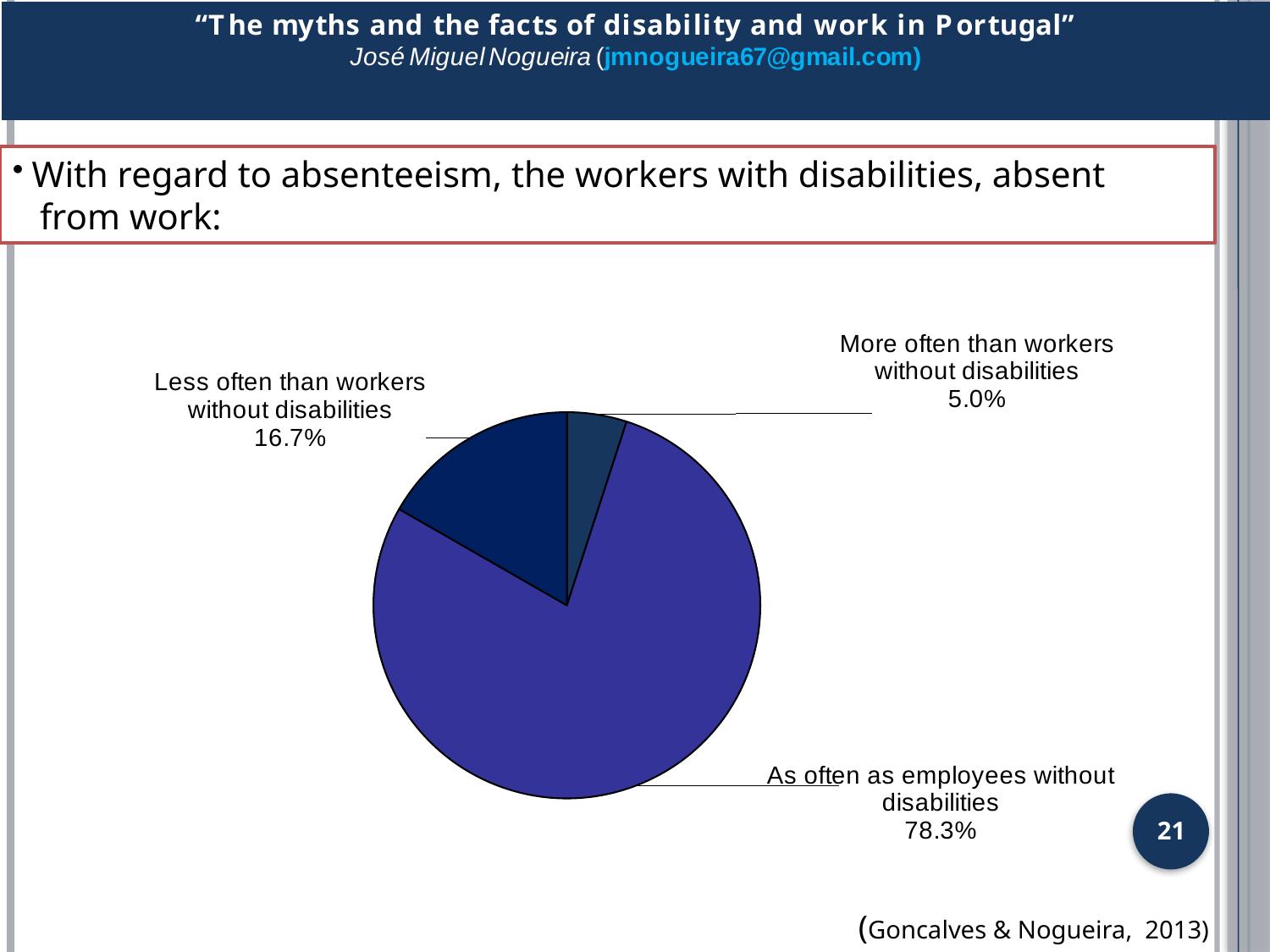
What share of the pie is labelled "As often as employees without disabilities"? 78.3% What share of the pie is labelled "More often than workers without disabilities"? 5.0% What is the combined share of the "Less often" and "More often" slices? 21.7% What source is cited below the pie chart? Goncalves & Nogueira, 2013 What is the difference between the "As often as employees without disabilities" share and the "Less often than workers without disabilities" share? 61.6% What kind of chart is shown on the slide? pie chart Which category has the largest slice of the pie? As often as employees without disabilities What is the difference between the "Less often than workers without disabilities" share and the "More often than workers without disabilities" share? 11.7% How many slices does the pie chart have? 3 Which is larger: the slice for "Less often than workers without disabilities" or the slice for "More often than workers without disabilities"? Less often than workers without disabilities Which category has the smallest slice of the pie? More often than workers without disabilities What share of the pie is labelled "Less often than workers without disabilities"? 16.7%